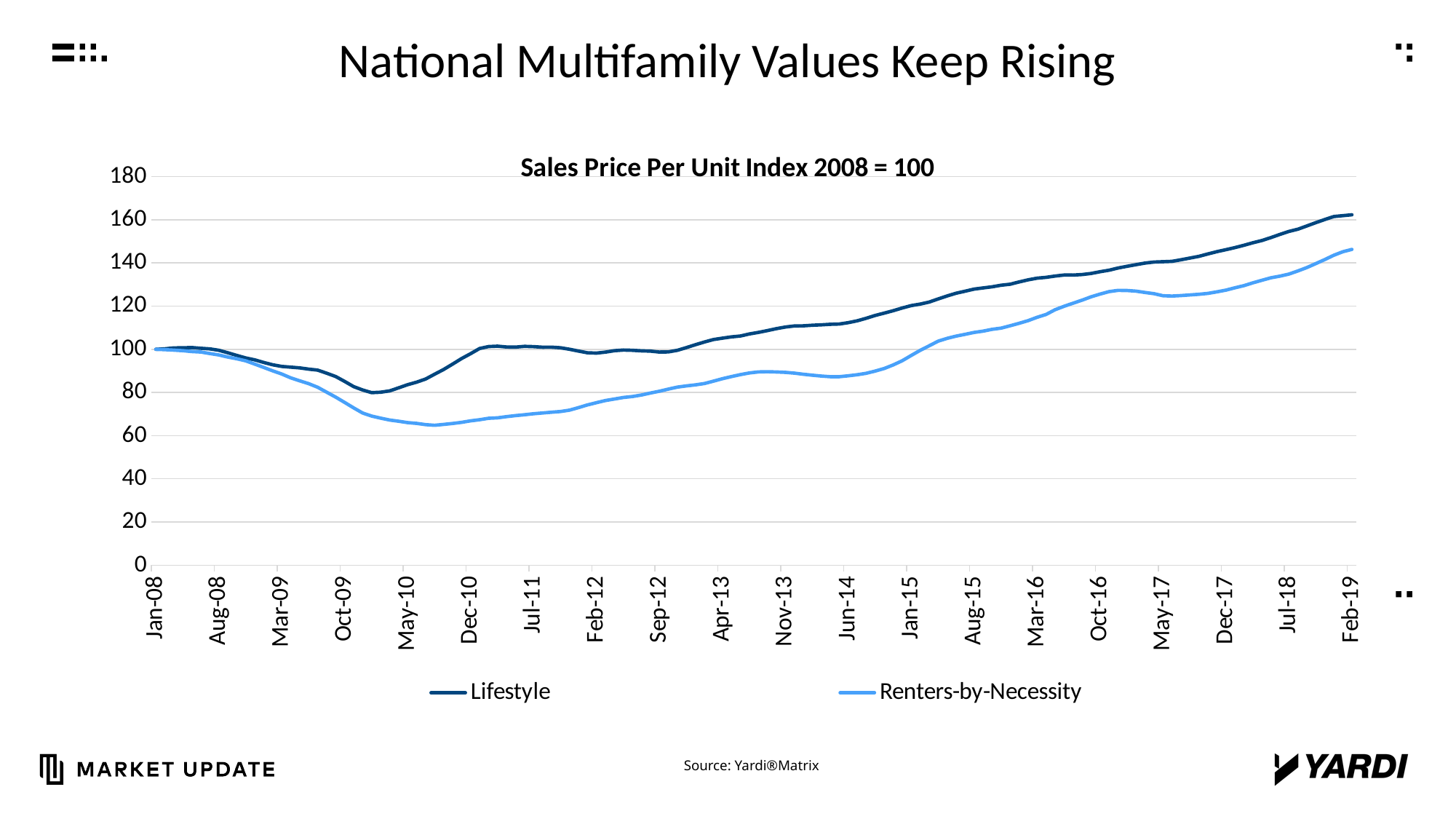
Overall, do the index values rise or fall from Jan-08 to Feb-19? Rise How many series does the legend list? 2 Is the Lifestyle value at Oct-16 greater or less than 120? greater Which series reaches the lowest point on the chart? Renters-by-Necessity Is the Renters-by-Necessity value at Feb-19 greater or less than 140? greater What is the title of the chart? Sales Price Per Unit Index 2008 = 100 What is the value of the Renters-by-Necessity index at Jan-08? 100 Is the Renters-by-Necessity value at May-10 greater or less than 80? less At Feb-19, which series has the higher value, Lifestyle or Renters-by-Necessity? Lifestyle What is the value of the Lifestyle index at Jan-08? 100 What type of chart is shown on the slide? Line chart